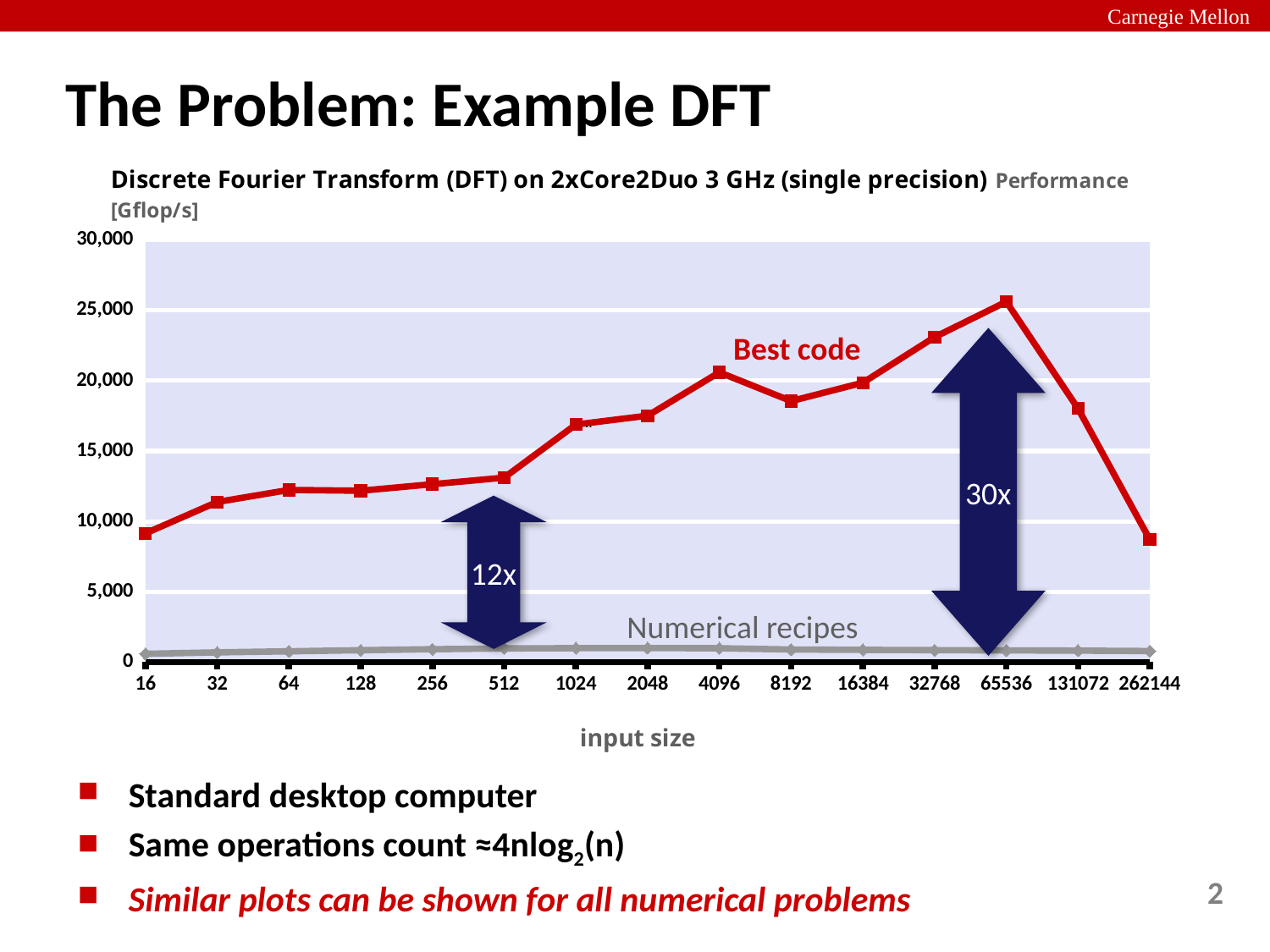
At which input size does the Best code series reach its highest performance? 65536 Is the Best code value at input size 512 greater or less than 10,000? greater Which input size has the higher Best code value, 65536 or 131072? 65536 How many input sizes are plotted along the x axis? 15 What kind of chart is shown on the slide? line chart How many data series are plotted in the chart? 2 Is the Numerical recipes value at input size 512 greater or less than 5,000? less Is the Best code value at input size 32768 greater or less than 20,000? greater Which series has the higher value at input size 65536, Best code or Numerical recipes? Best code What speedup factor is annotated by the large arrow at input size 65536? 30x Does the Best code series rise or fall from input size 16 to input size 65536? rise